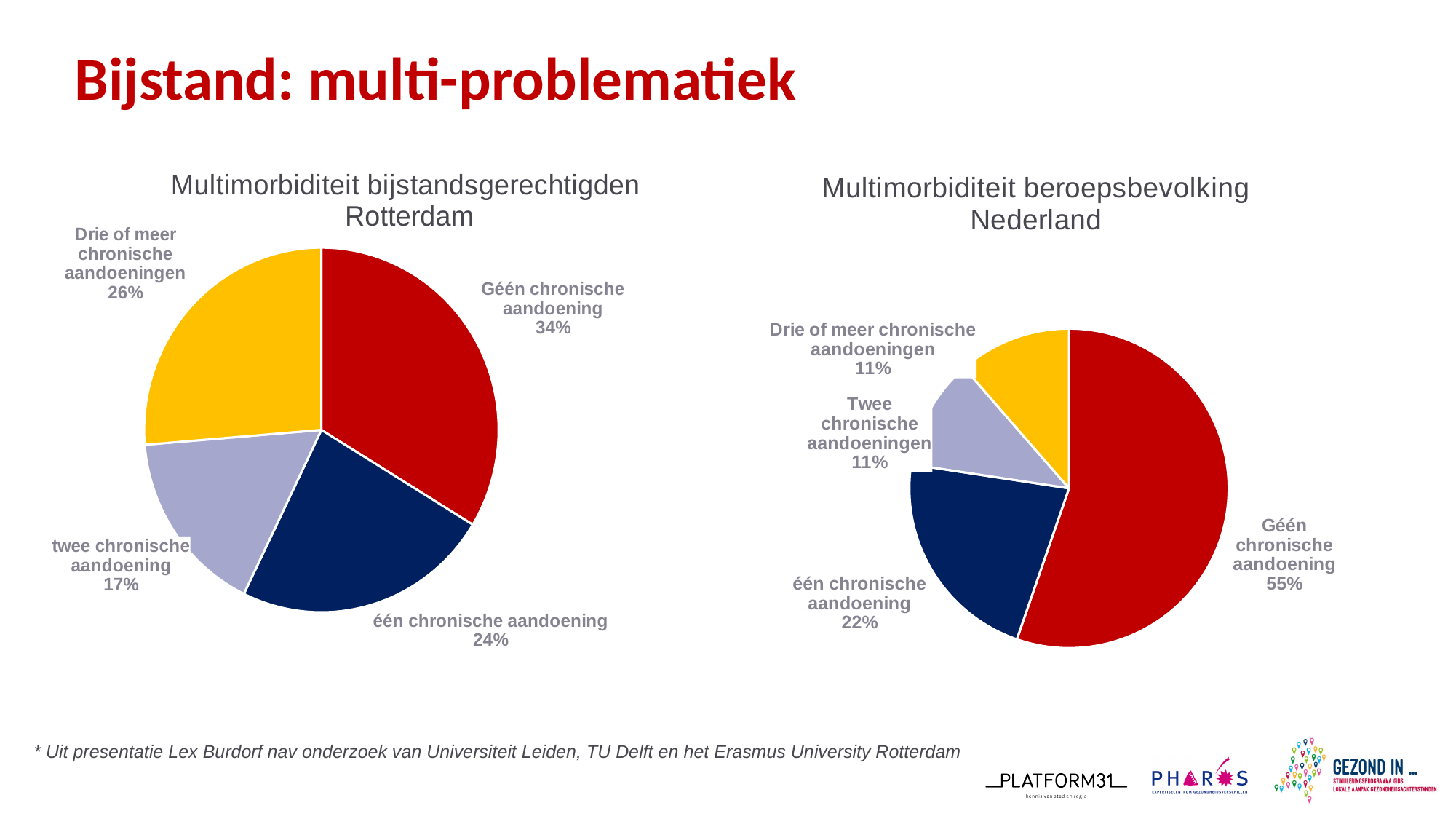
In the chart 'Multimorbiditeit beroepsbevolking Nederland', what colour is the 'Géén chronische aandoening' slice? Red In the chart 'Multimorbiditeit bijstandsgerechtigden Rotterdam', what share is 'Drie of meer chronische aandoeningen'? 26% Which is larger: 'Drie of meer chronische aandoeningen' in the Rotterdam chart or 'Drie of meer chronische aandoeningen' in the Nederland chart? Rotterdam chart In the chart 'Multimorbiditeit bijstandsgerechtigden Rotterdam', what is the difference between 'Géén chronische aandoening' and 'één chronische aandoening'? 10% In the chart 'Multimorbiditeit bijstandsgerechtigden Rotterdam', which category has the smallest slice? twee chronische aandoening In the chart 'Multimorbiditeit beroepsbevolking Nederland', which category has the largest slice? Géén chronische aandoening In the chart 'Multimorbiditeit beroepsbevolking Nederland', what share is 'Géén chronische aandoening'? 55% In the chart 'Multimorbiditeit bijstandsgerechtigden Rotterdam', what share is 'Géén chronische aandoening'? 34% What type of chart is 'Multimorbiditeit beroepsbevolking Nederland'? Pie chart In the chart 'Multimorbiditeit beroepsbevolking Nederland', what is the difference between 'Géén chronische aandoening' and 'één chronische aandoening'? 33% In the chart 'Multimorbiditeit beroepsbevolking Nederland', what share is 'één chronische aandoening'? 22% How many slices does the chart 'Multimorbiditeit bijstandsgerechtigden Rotterdam' have? 4